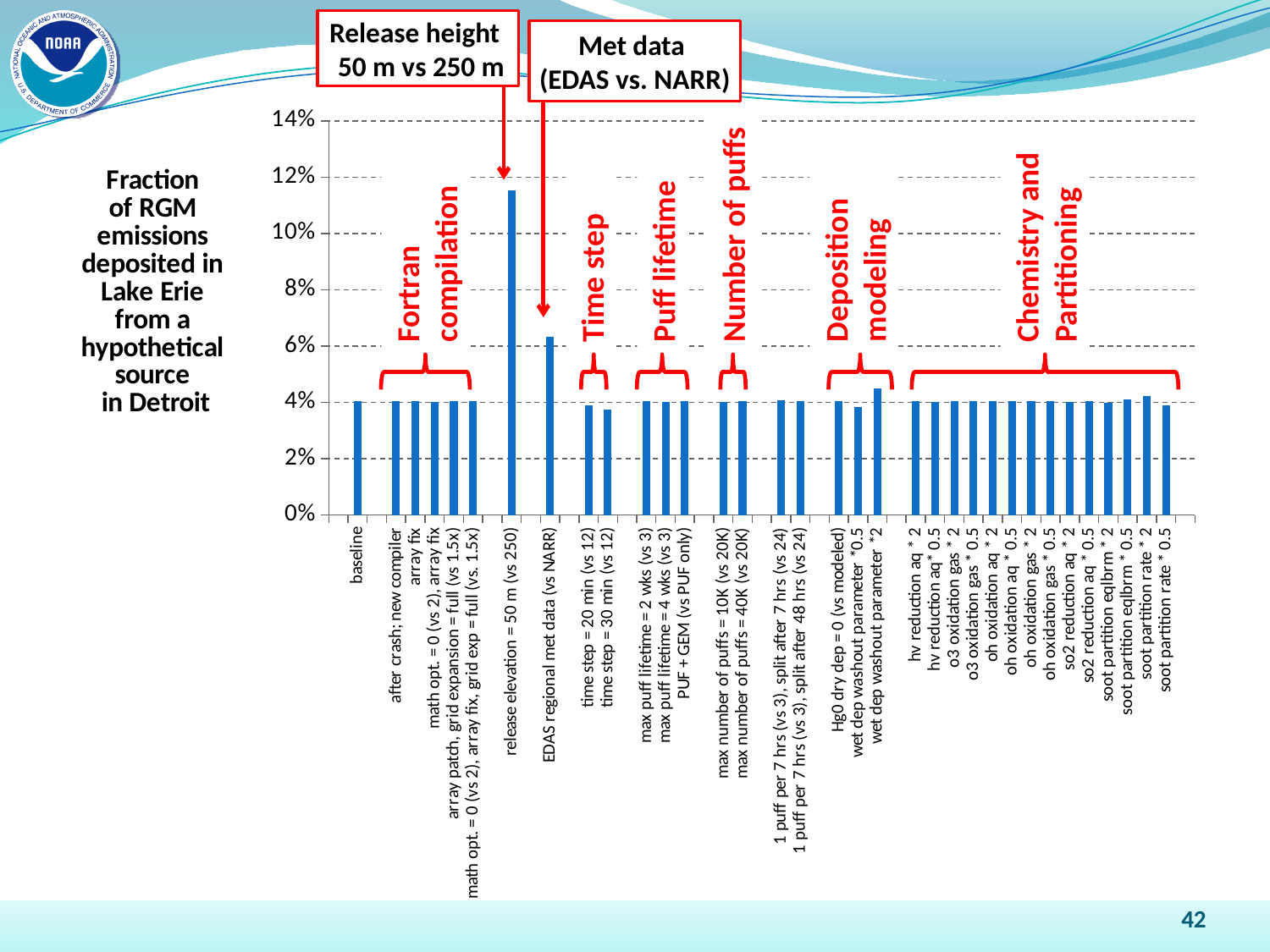
Is the value for 'time step = 30 min (vs 12)' greater or less than 4%? less Is the value for 'baseline' greater or less than 6%? less What kind of chart is shown on the slide? bar chart What is the highest tick value shown on the y axis of the chart? 14% Is the value for 'EDAS regional met data (vs NARR)' greater or less than 8%? less Which is larger, the value for 'release elevation = 50 m (vs 250)' or the value for 'EDAS regional met data (vs NARR)'? release elevation = 50 m (vs 250) Which category has the highest fraction of RGM emissions deposited in Lake Erie? release elevation = 50 m (vs 250) Which is larger, the value for 'wet dep washout parameter *2' or the value for 'wet dep washout parameter *0.5'? wet dep washout parameter *2 According to the text to the left of the chart, what quantity does the chart show? Fraction of RGM emissions deposited in Lake Erie from a hypothetical source in Detroit Which is larger, the value for 'EDAS regional met data (vs NARR)' or the value for 'baseline'? EDAS regional met data (vs NARR)